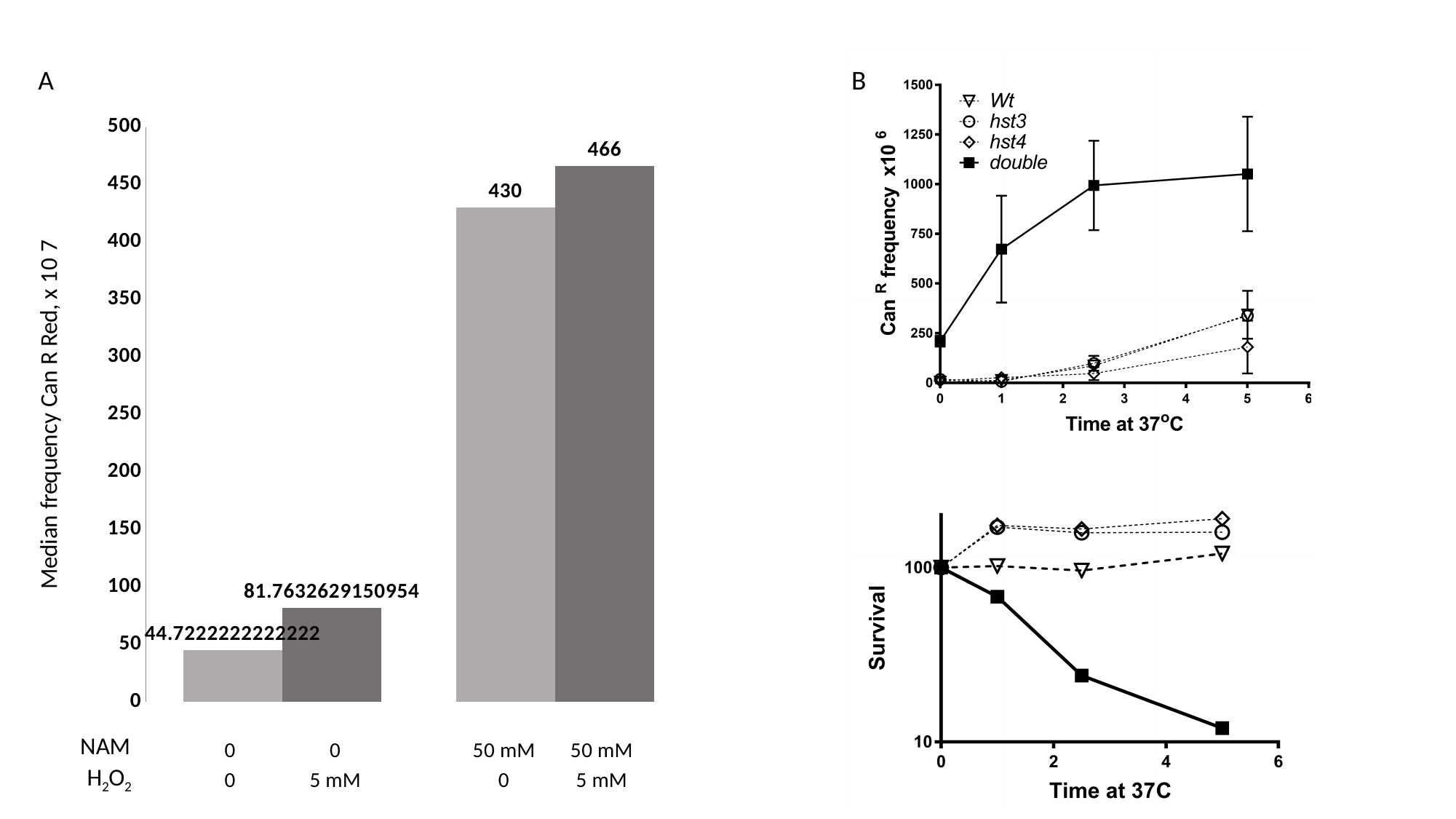
What kind of chart is panel A? bar chart In panel A, what is the difference between the NAM 50 mM / H2O2 5 mM bar and the NAM 50 mM / H2O2 0 bar? 36 How many bars are plotted in panel A? 4 How many series does the legend of the top chart in panel B list? 4 In panel A, what is the median frequency for NAM 50 mM with H2O2 5 mM? 466 In panel A, which condition has the highest bar? NAM 50 mM, H2O2 5 mM In the top chart of panel B, is the Can R frequency for the double strain at time 5 greater or less than 750? greater In panel A, which condition has the lowest bar? NAM 0, H2O2 0 In panel A, what is the median frequency for NAM 0 with H2O2 5 mM? 81.7632629150954 In the bottom chart of panel B, does survival for the double strain rise or fall over time at 37C? fall In panel A, what is the median frequency for NAM 0 with H2O2 0? 44.7222222222222 In the bottom chart of panel B, at time 5, which has higher survival: Wt or double? Wt